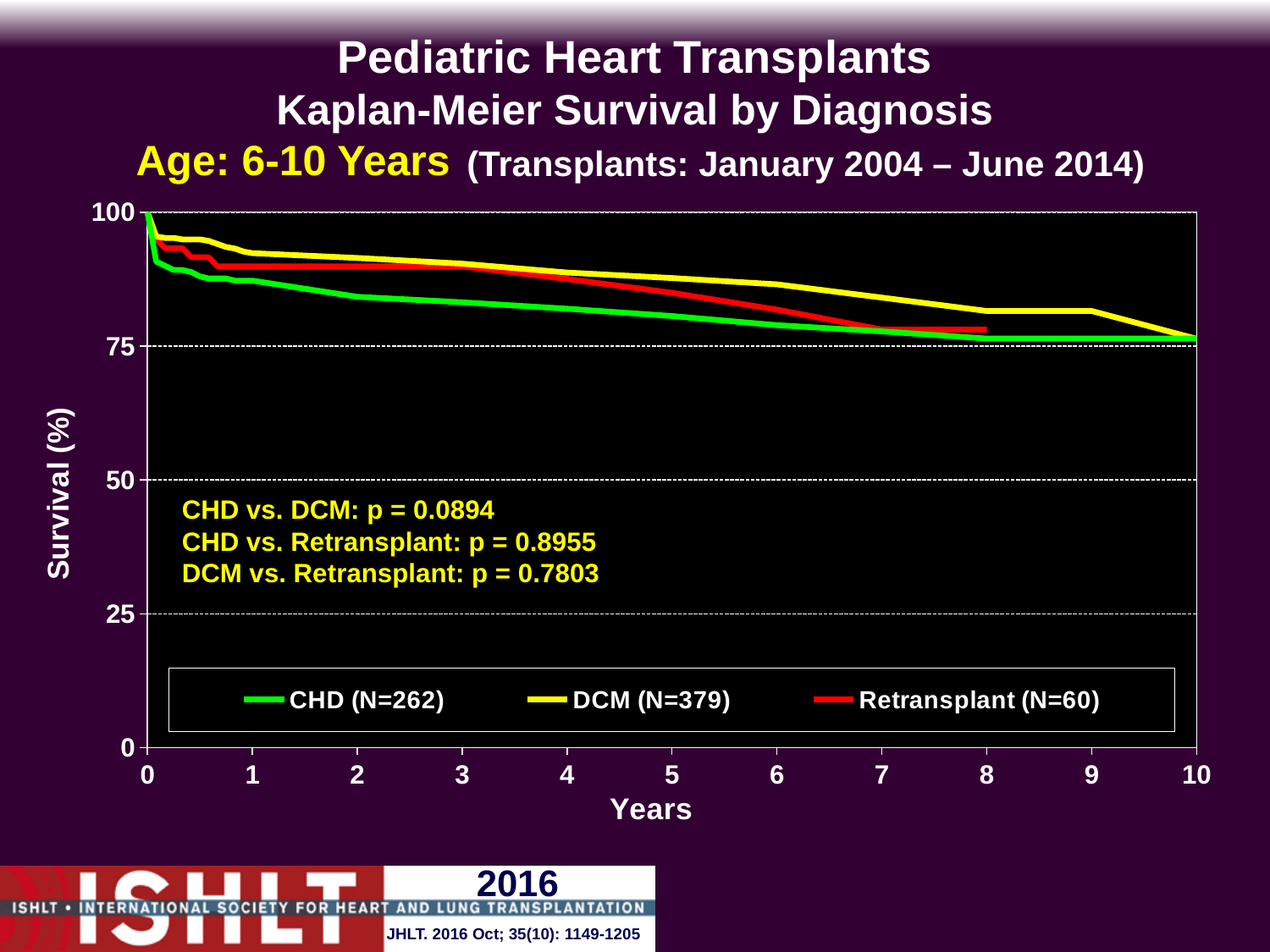
What is the N for the Retransplant group shown in the legend? 60 What is the p-value for CHD vs. DCM? 0.0894 What is the p-value for DCM vs. Retransplant? 0.7803 What is the N for the DCM group shown in the legend? 379 What kind of chart is shown on the slide? line chart Is the survival for CHD at 5 years greater or less than 75? greater How many series does the legend list? 3 At 5 years, which series has the lowest survival? CHD At 5 years, which series has the highest survival? DCM At 1 year, is survival higher for DCM or for CHD? DCM Is the survival for DCM at 8 years greater or less than 75? greater Do the survival curves rise or fall as years increase? fall